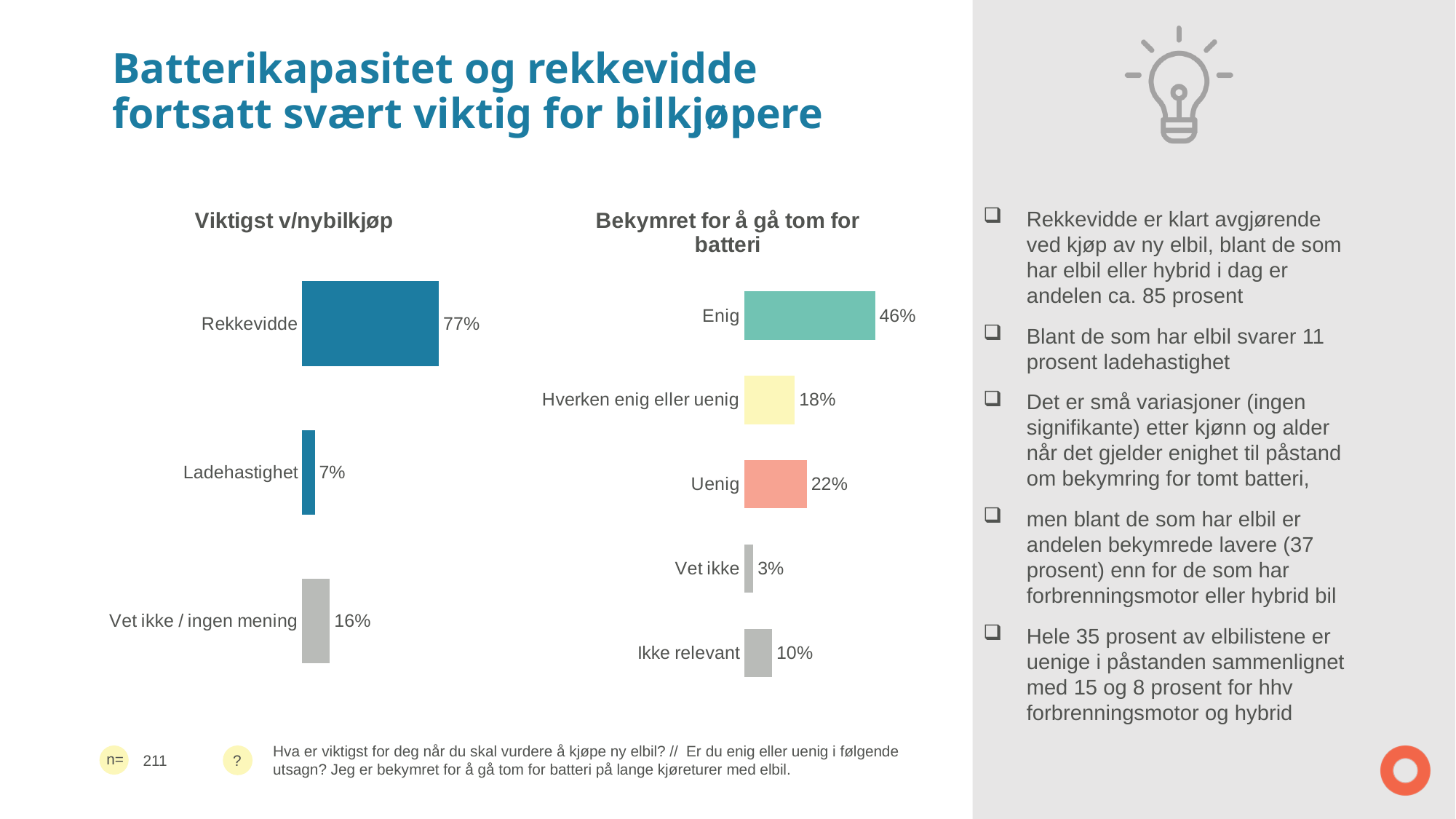
In the 'Bekymret for å gå tom for batteri' chart, which is larger: Uenig or Hverken enig eller uenig? Uenig In the 'Viktigst v/nybilkjøp' chart, which category has the lowest value? Ladehastighet In the 'Viktigst v/nybilkjøp' chart, what is the value for Rekkevidde? 77% In the 'Viktigst v/nybilkjøp' chart, what is the difference between Rekkevidde and Vet ikke / ingen mening? 61% In the 'Bekymret for å gå tom for batteri' chart, what is the value for Enig? 46% In the 'Bekymret for å gå tom for batteri' chart, what is the value for Ikke relevant? 10% In the 'Bekymret for å gå tom for batteri' chart, which category has the highest value? Enig In the 'Bekymret for å gå tom for batteri' chart, which category has the lowest value? Vet ikke In the 'Viktigst v/nybilkjøp' chart, what is the value for Ladehastighet? 7% In the 'Bekymret for å gå tom for batteri' chart, what is the difference between Enig and Uenig? 24% What type of chart is the 'Bekymret for å gå tom for batteri' chart? Bar chart In the 'Viktigst v/nybilkjøp' chart, how many categories are shown? 3